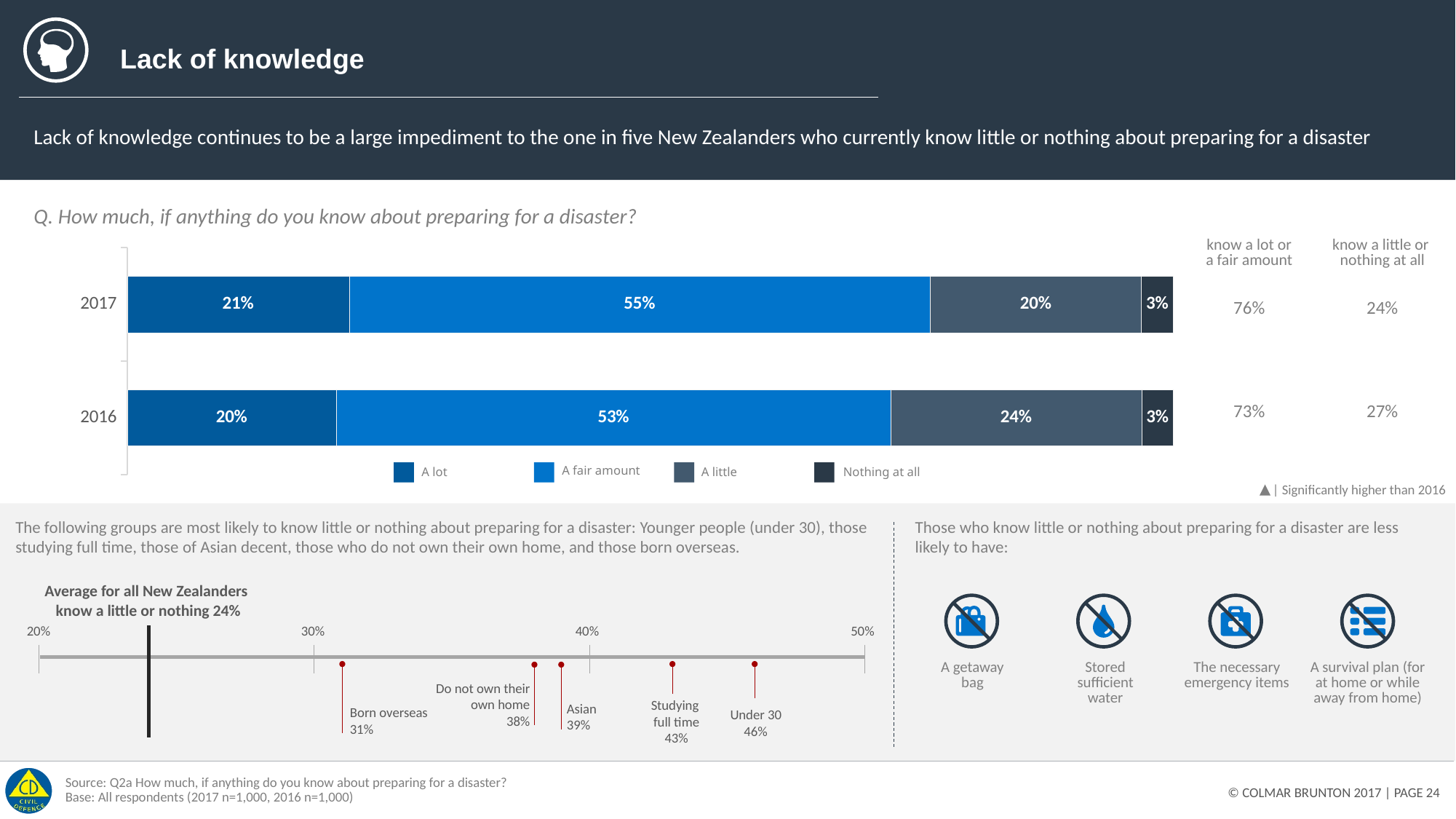
In the stacked bar chart, what percentage of respondents in 2017 said they know 'A fair amount' about preparing for a disaster? 55% In the stacked bar chart, how many series does the legend list? 4 In the stacked bar chart, what is the difference between the 'A fair amount' values for 2017 and 2016? 2% In the stacked bar chart, what is the combined percentage for 'A lot' and 'A fair amount' in 2017, as shown in the summary column? 76% In the number line chart at the bottom left, how many groups are plotted? 5 In the stacked bar chart, what percentage said 'Nothing at all' in 2017? 3% In the stacked bar chart, which year has the larger 'A little' share, 2017 or 2016? 2016 In the number line chart at the bottom left, which group has the highest percentage who know little or nothing about preparing for a disaster? Under 30 What type of chart is used to show how much people know about preparing for a disaster by year? Stacked bar chart In the number line chart at the bottom left, what is the value for 'Studying full time'? 43% In the number line chart at the bottom left, which group has the lowest percentage who know little or nothing? Born overseas In the stacked bar chart, what percentage of respondents in 2016 said they know 'A little'? 24%